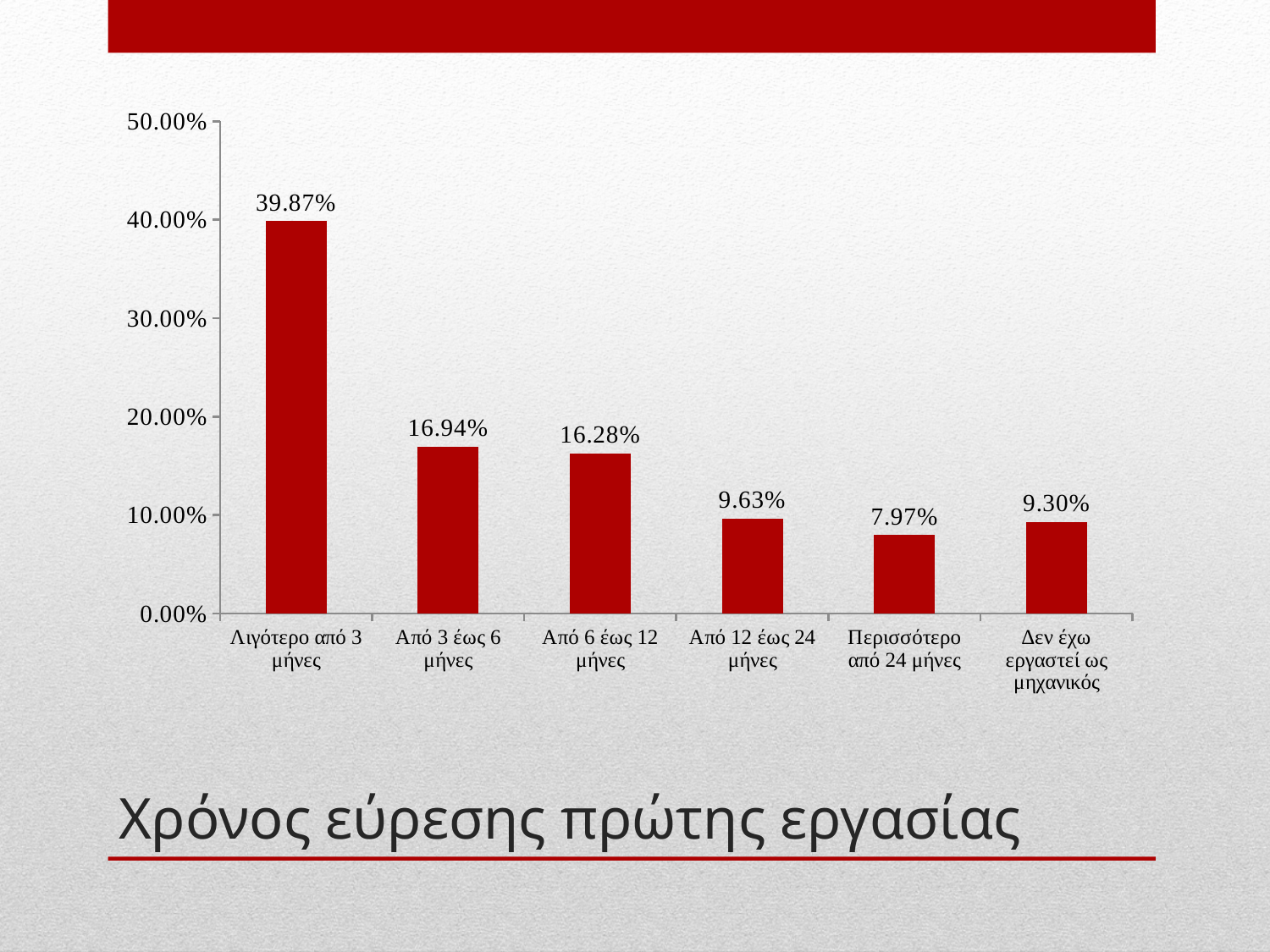
What kind of chart is shown on the slide? bar chart Is the value for 'Από 3 έως 6 μήνες' greater or less than 20.00%? less What is the value for 'Λιγότερο από 3 μήνες'? 39.87% What is the value for 'Δεν έχω εργαστεί ως μηχανικός'? 9.30% What colour are the bars in the chart? dark red How many categories are shown on the x axis? 6 What is the value for 'Από 12 έως 24 μήνες'? 9.63% Which category has the lowest value? Περισσότερο από 24 μήνες Which is larger, the value for 'Από 12 έως 24 μήνες' or the value for 'Περισσότερο από 24 μήνες'? Από 12 έως 24 μήνες Which category has the highest value? Λιγότερο από 3 μήνες What is the difference between the values for 'Από 3 έως 6 μήνες' and 'Από 6 έως 12 μήνες'? 0.66% What is the title of the slide? Χρόνος εύρεσης πρώτης εργασίας